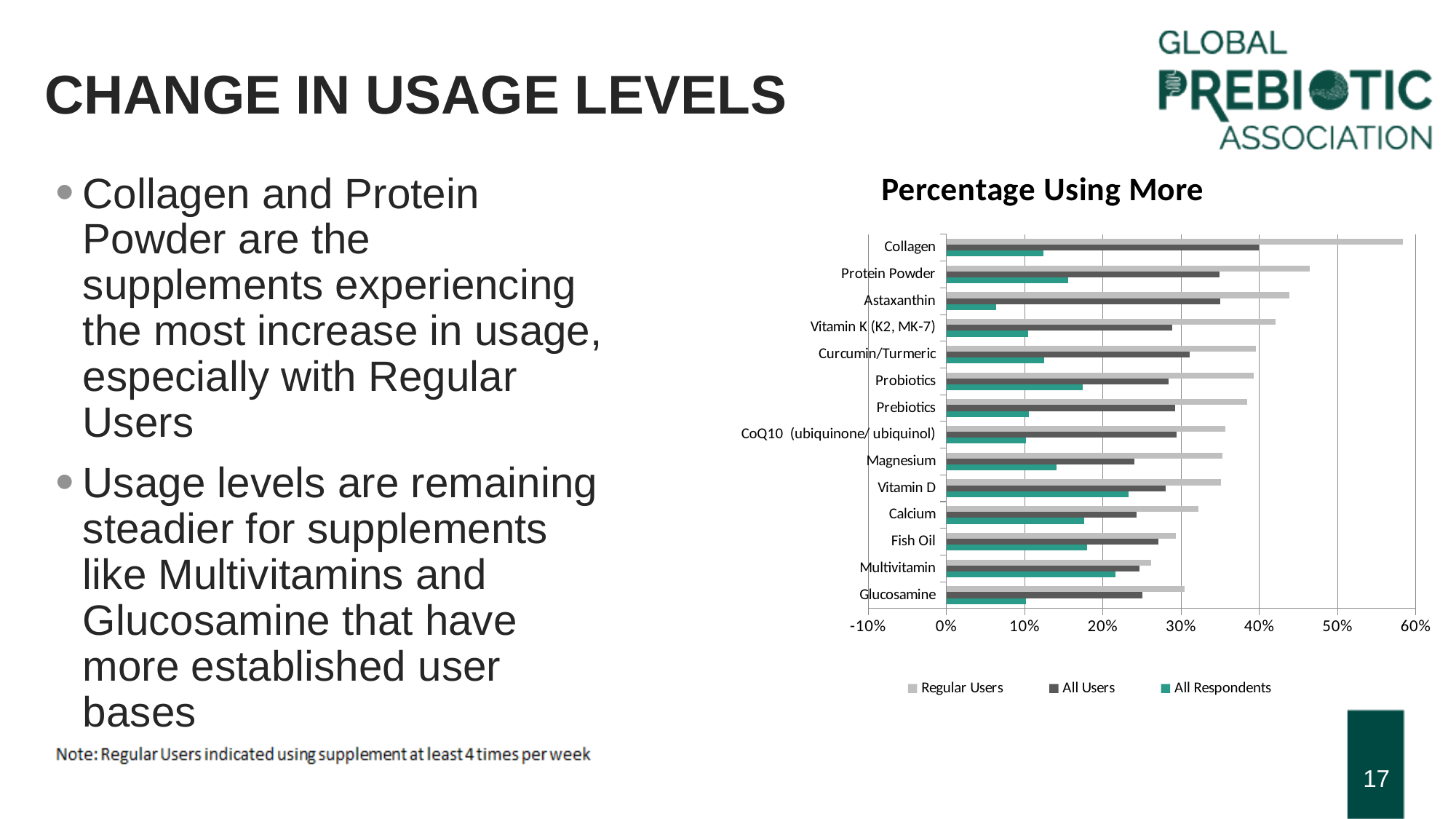
What type of chart is shown on the slide? bar chart What is the title of the chart? Percentage Using More Which supplement has the lowest value for All Respondents? Astaxanthin Which supplement has the highest value for All Users? Collagen Is the Regular Users value for Collagen greater or less than 50%? greater Which is larger for Regular Users: Collagen or Protein Powder? Collagen How many supplement categories are shown in the chart? 14 Is the All Users value for Magnesium greater or less than 30%? less How many series does the chart legend list? 3 Is the All Respondents value for Astaxanthin greater or less than 10%? less Which supplement has the lowest value for Regular Users? Multivitamin Which supplement has the highest value for Regular Users? Collagen